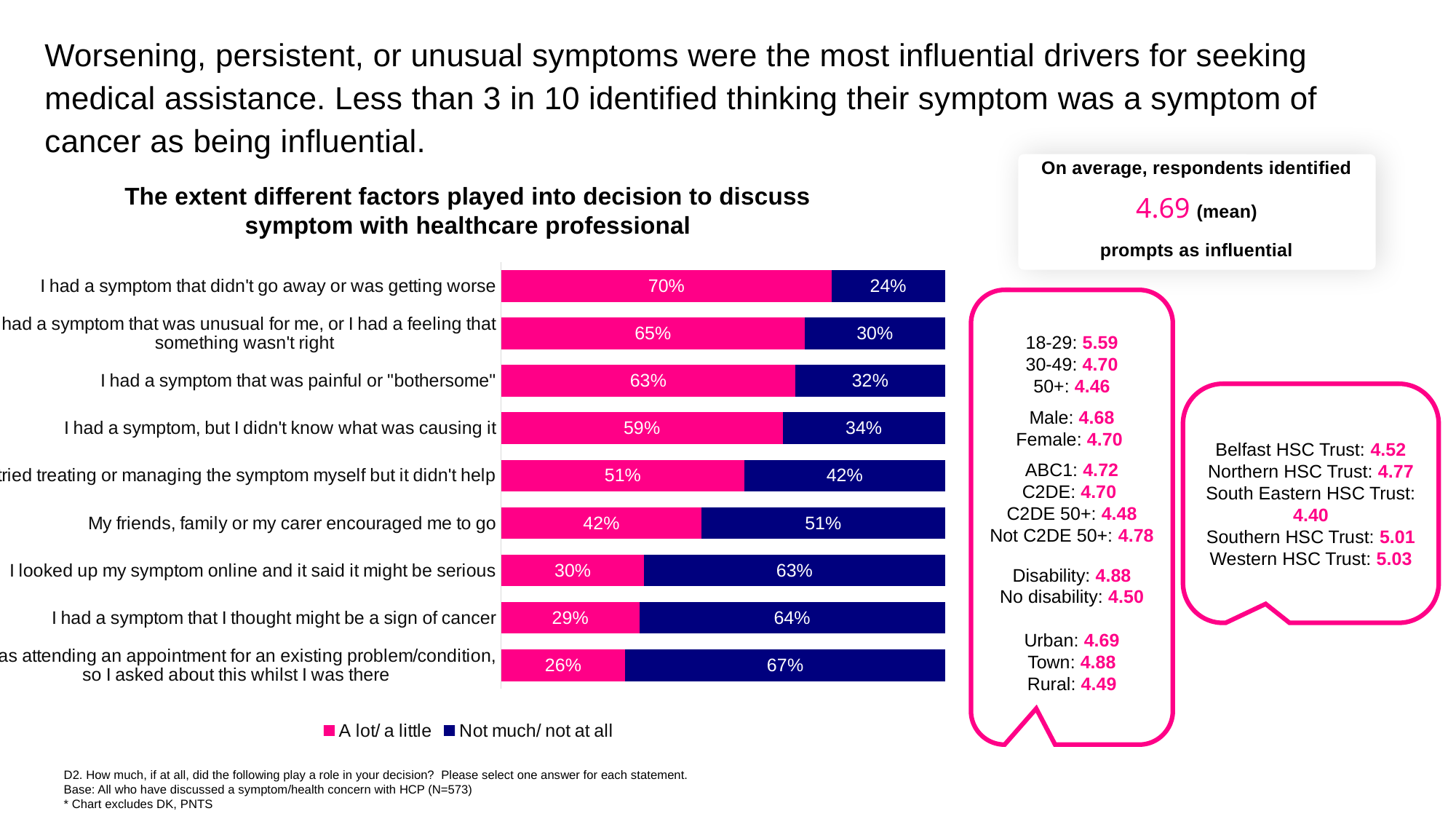
Which statement has the highest "A lot/ a little" percentage? I had a symptom that didn't go away or was getting worse How many series does the chart legend list? 2 What is the difference between the "A lot/ a little" and "Not much/ not at all" values for "I had a symptom that was painful or "bothersome""? 31% What is the "Not much/ not at all" value for "I had a symptom that I thought might be a sign of cancer"? 64% What percentage of respondents said "A lot/ a little" for "I had a symptom that didn't go away or was getting worse"? 70% What colour represents the "Not much/ not at all" series in the chart? Dark blue Which is larger for "I looked up my symptom online and it said it might be serious": the "A lot/ a little" value or the "Not much/ not at all" value? Not much/ not at all What is the "A lot/ a little" value for "My friends, family or my carer encouraged me to go"? 42% What is the total of the two labelled segments for "I had a symptom, but I didn't know what was causing it"? 93% Which statement has the lowest "A lot/ a little" percentage? I was attending an appointment for an existing problem/condition, so I asked about this whilst I was there How many statements (categories) are plotted in the chart? 9 What kind of chart is shown on the slide? Stacked bar chart